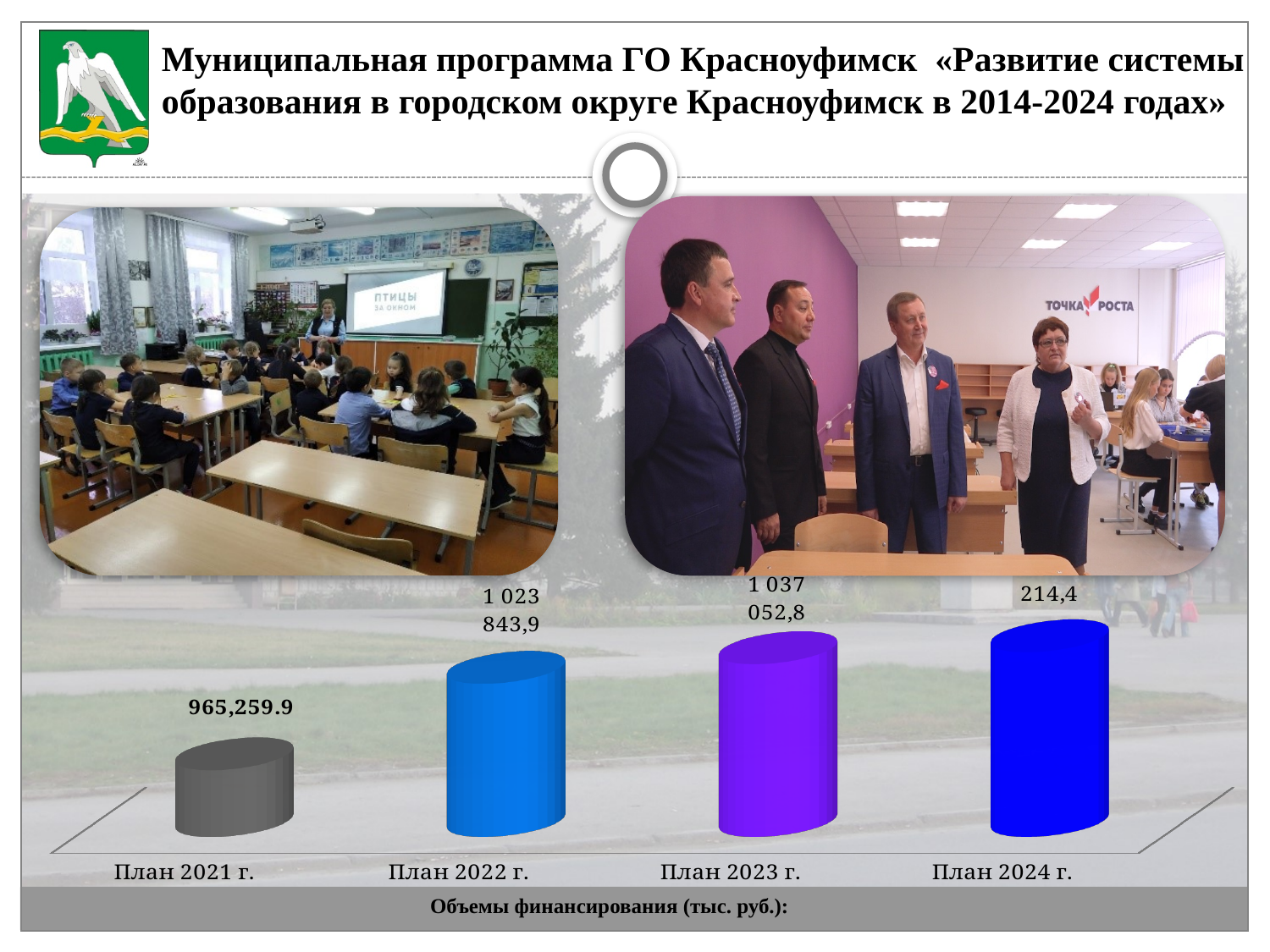
What is the value shown for План 2022 г.? 1 023 843,9 Which category has the tallest bar? План 2024 г. What kind of chart is shown on the slide? Bar chart What colour is the bar for План 2021 г.? Gray What caption is shown below the chart? Объемы финансирования (тыс. руб.): Do the bar heights rise or fall from План 2021 г. to План 2024 г.? Rise What is the difference between the values for План 2023 г. and План 2022 г.? 13 208,9 Which is larger, the value for План 2022 г. or План 2021 г.? План 2022 г. What is the value shown for План 2023 г.? 1 037 052,8 Which category has the lowest bar? План 2021 г. What is the value shown for План 2021 г.? 965,259.9 How many categories are shown in the chart? 4